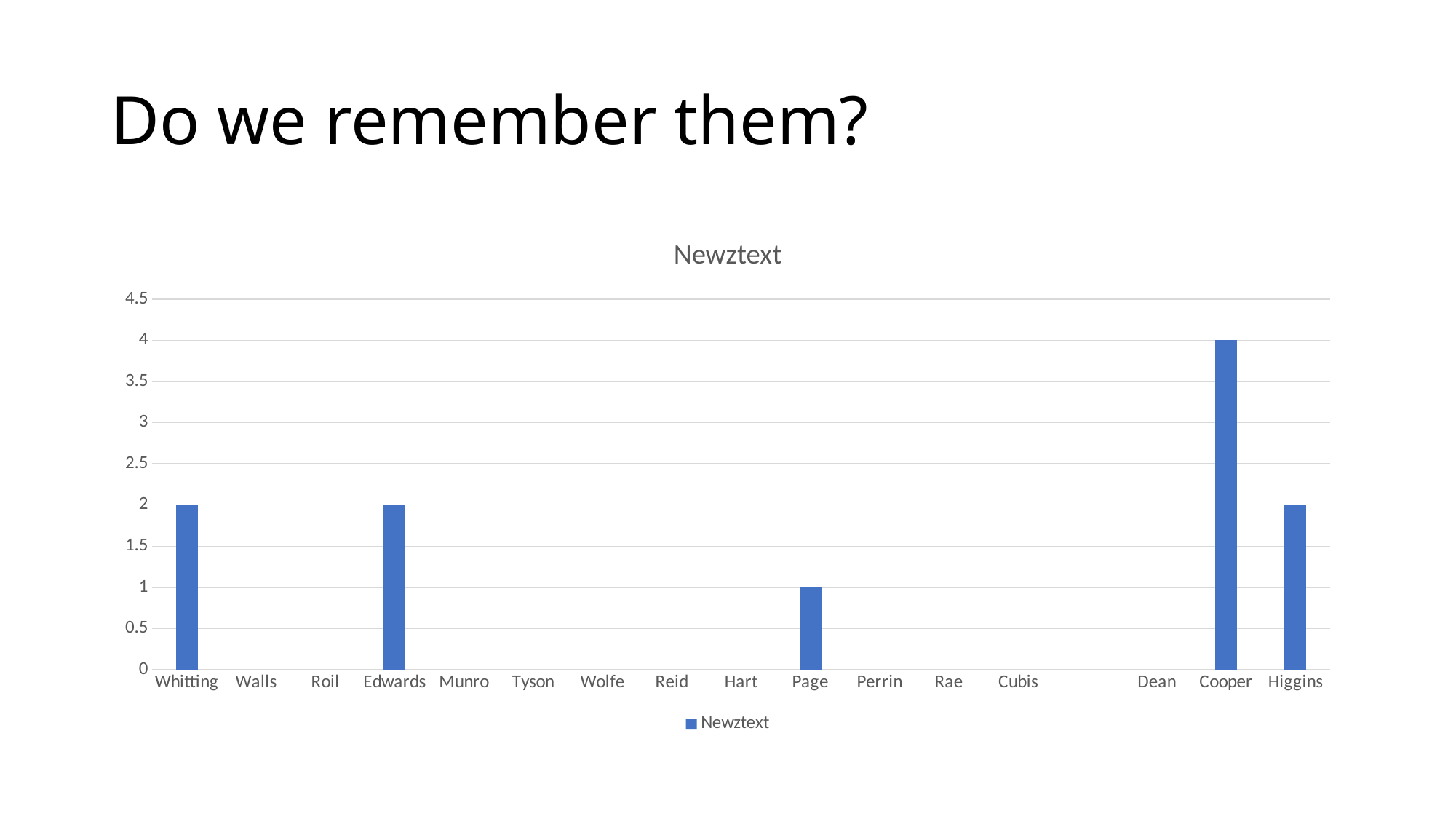
What is the difference between the values for Cooper and Page? 3 What is the value for Page? 1 How many bars are drawn on the chart? 5 Is the value for Cooper greater or less than 3? greater Which is larger, the value for Cooper or the value for Higgins? Cooper What is the value for Higgins? 2 What is the value for Cooper? 4 What is the value for Whitting? 2 Which category has the highest value? Cooper How many series does the legend list? 1 What is the difference between the values for Cooper and Edwards? 2 What kind of chart is shown? bar chart